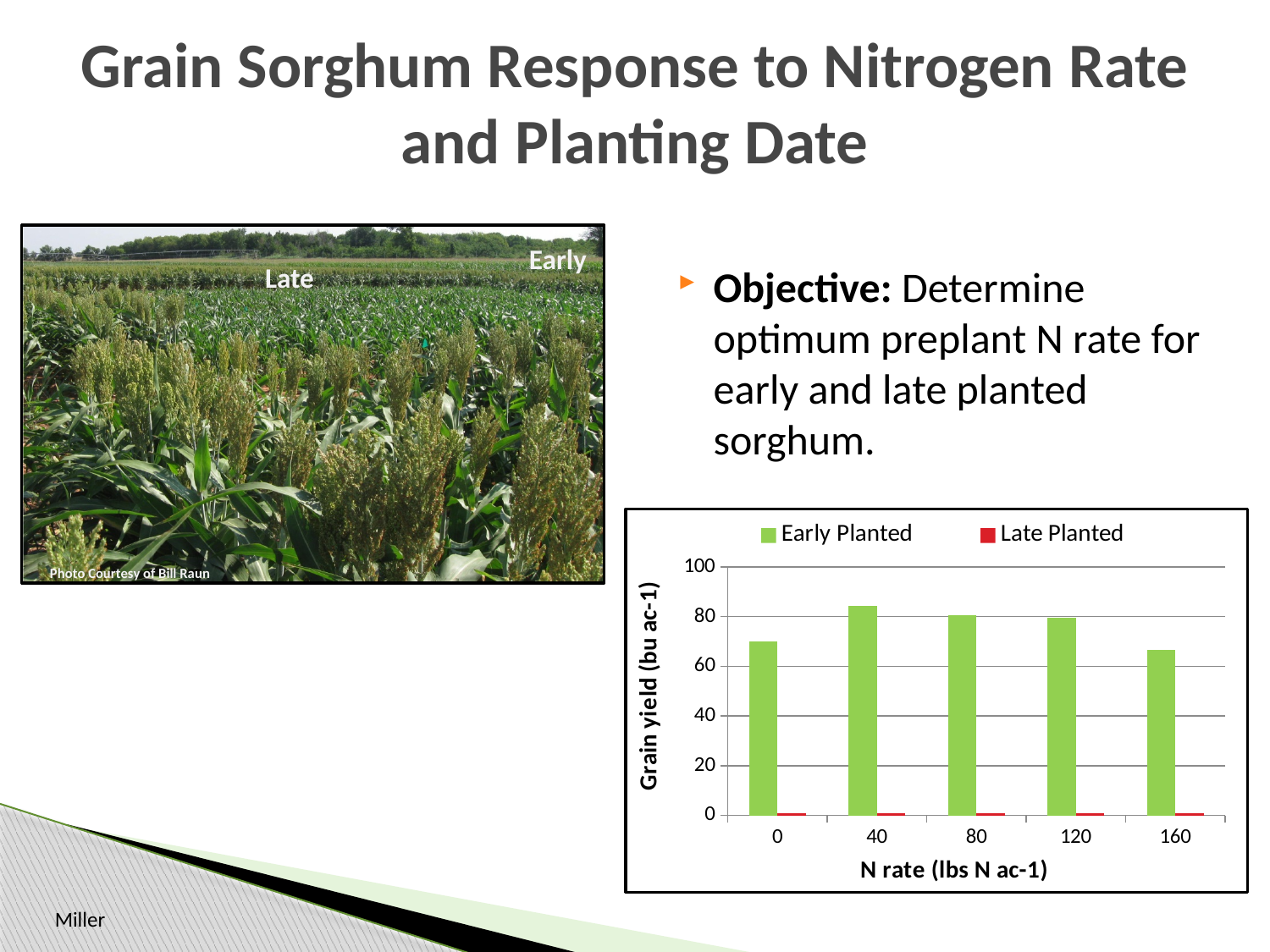
Is the Early Planted grain yield at an N rate of 0 greater or less than 80? less Which has the larger Early Planted grain yield: an N rate of 40 or an N rate of 160? 40 Is the Early Planted grain yield at an N rate of 40 greater or less than 80? greater Is the Early Planted grain yield at an N rate of 160 greater or less than 60? greater How many N rate categories are shown on the x axis of the chart? 5 How many series does the chart legend list? 2 What kind of chart is shown on the slide? bar chart At which N rate is the Early Planted grain yield highest? 40 What is the label on the y axis of the chart? Grain yield (bu ac-1) At which N rate is the Early Planted grain yield lowest? 160 Does the Early Planted grain yield rise or fall as the N rate increases from 40 to 160? fall